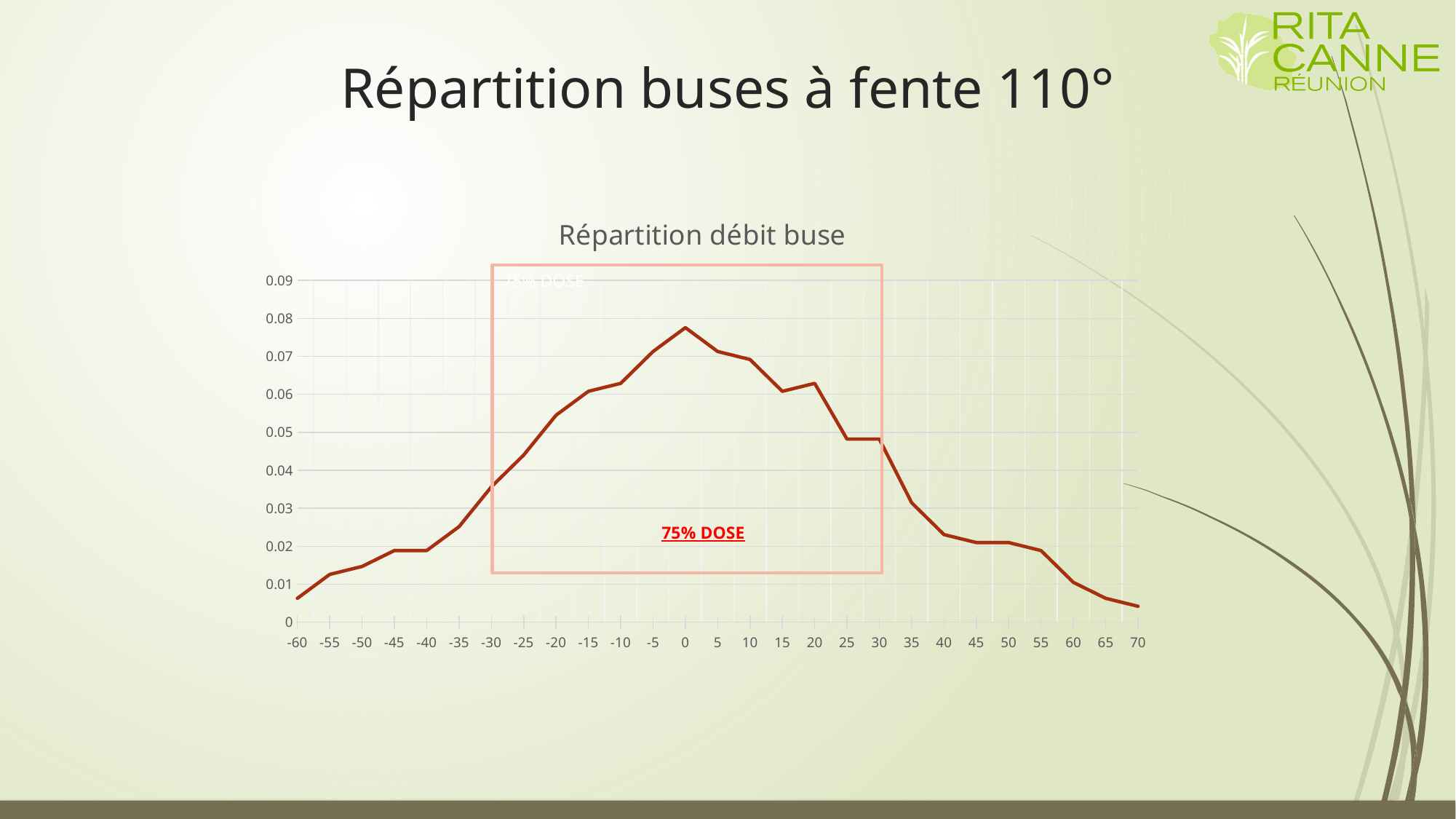
What is the title of the chart? Répartition débit buse Do the values rise or fall as x goes from -60 to 0? rise How many points are plotted along the x axis of the chart? 27 At which x-axis value does the line reach its highest point? 0 What label is written inside the red rectangle on the chart? 75% DOSE Which has the larger value, x = 5 or x = 25? 5 Is the value at x = 0 greater or less than 0.07? greater Do the values rise or fall as x goes from 0 to 70? fall Is the value at x = -30 greater or less than 0.03? greater Is the value at x = 60 greater or less than 0.02? less What kind of chart is shown on the slide? line chart